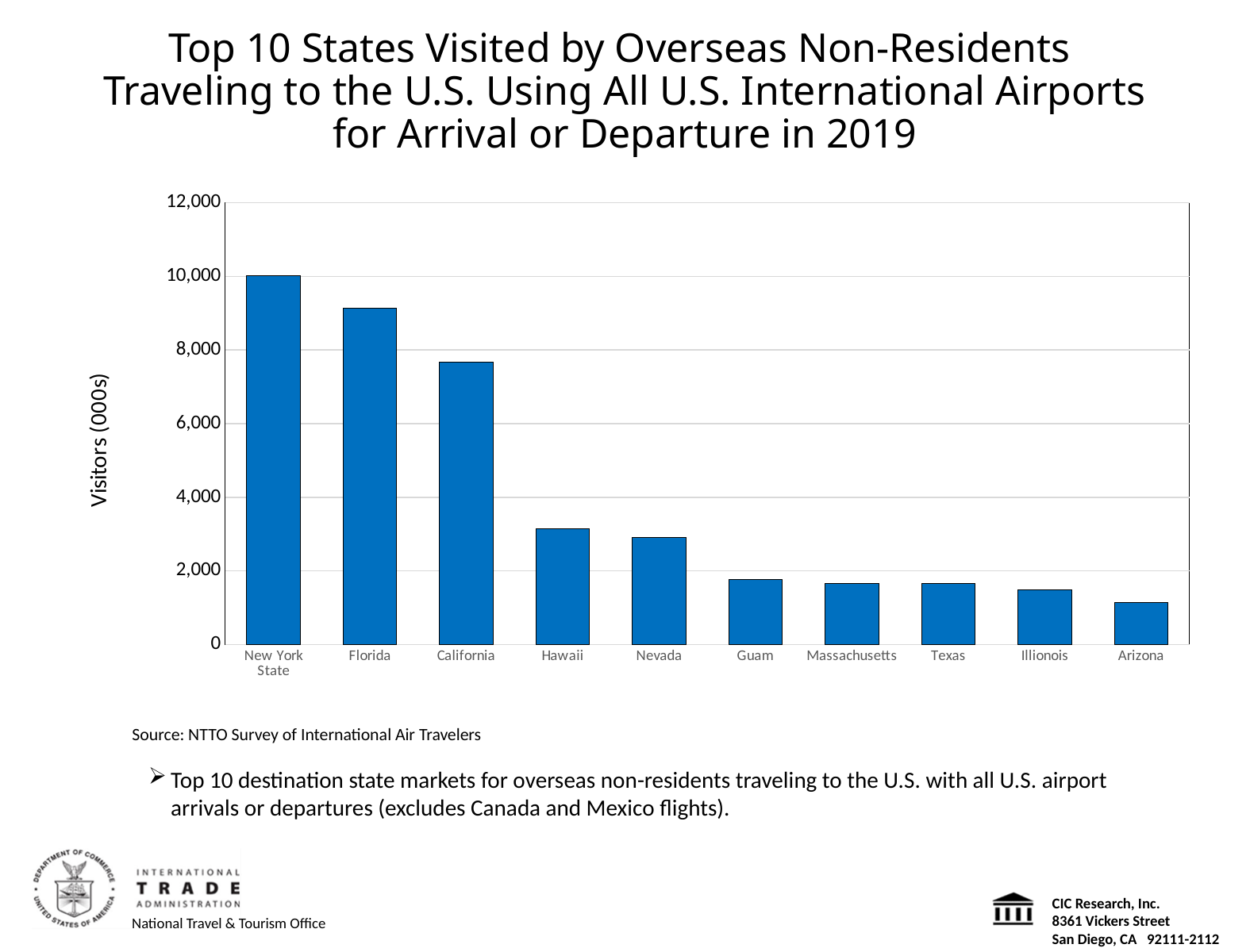
Is the value for Florida greater or less than 8,000? greater Which state has the highest number of visitors in the chart? New York State How many states are shown on the x axis of the chart? 10 What kind of chart is shown on the slide? Bar chart Which state has the lowest number of visitors in the chart? Arizona Is the value for California greater or less than 8,000? less Is the value for Guam greater or less than 2,000? less Which has more visitors, Florida or California? Florida Do the values rise or fall moving from left to right along the x axis? Fall Which has more visitors, Hawaii or Nevada? Hawaii What is the label on the y axis of the chart? Visitors (000s)